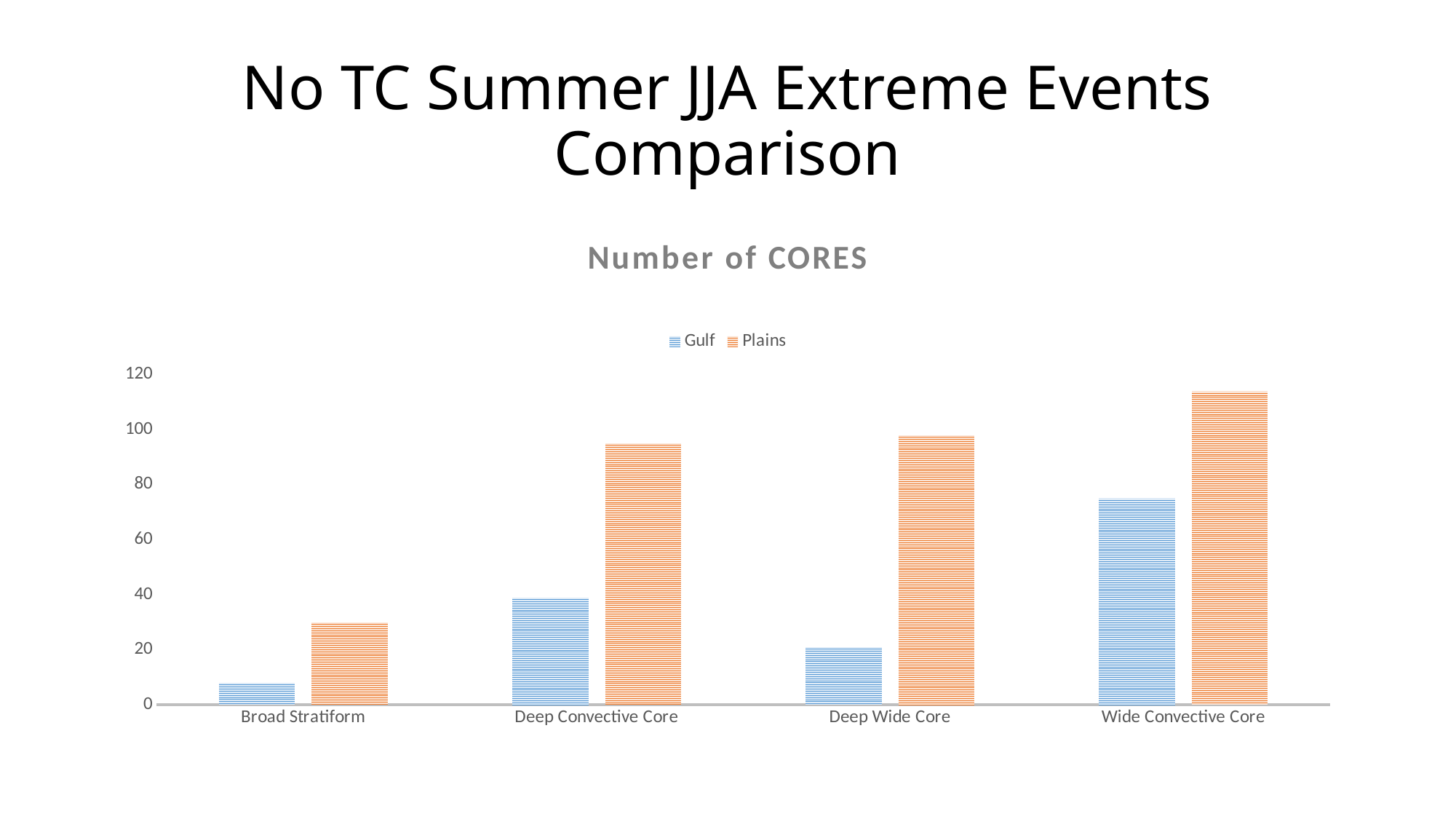
Which category has the highest Gulf value? Wide Convective Core What kind of chart is shown on the slide? bar chart What is the title of the chart? Number of CORES Is the Plains value for Wide Convective Core greater or less than 100? greater Which series is shown in orange? Plains Is the Gulf value for Wide Convective Core greater or less than 60? greater How many categories are shown on the x axis? 4 Which category has the highest Plains value? Wide Convective Core For Deep Convective Core, which series has the larger value, Gulf or Plains? Plains Which category has the lowest Gulf value? Broad Stratiform How many series does the legend list? 2 Is the Gulf value for Deep Wide Core greater or less than 40? less